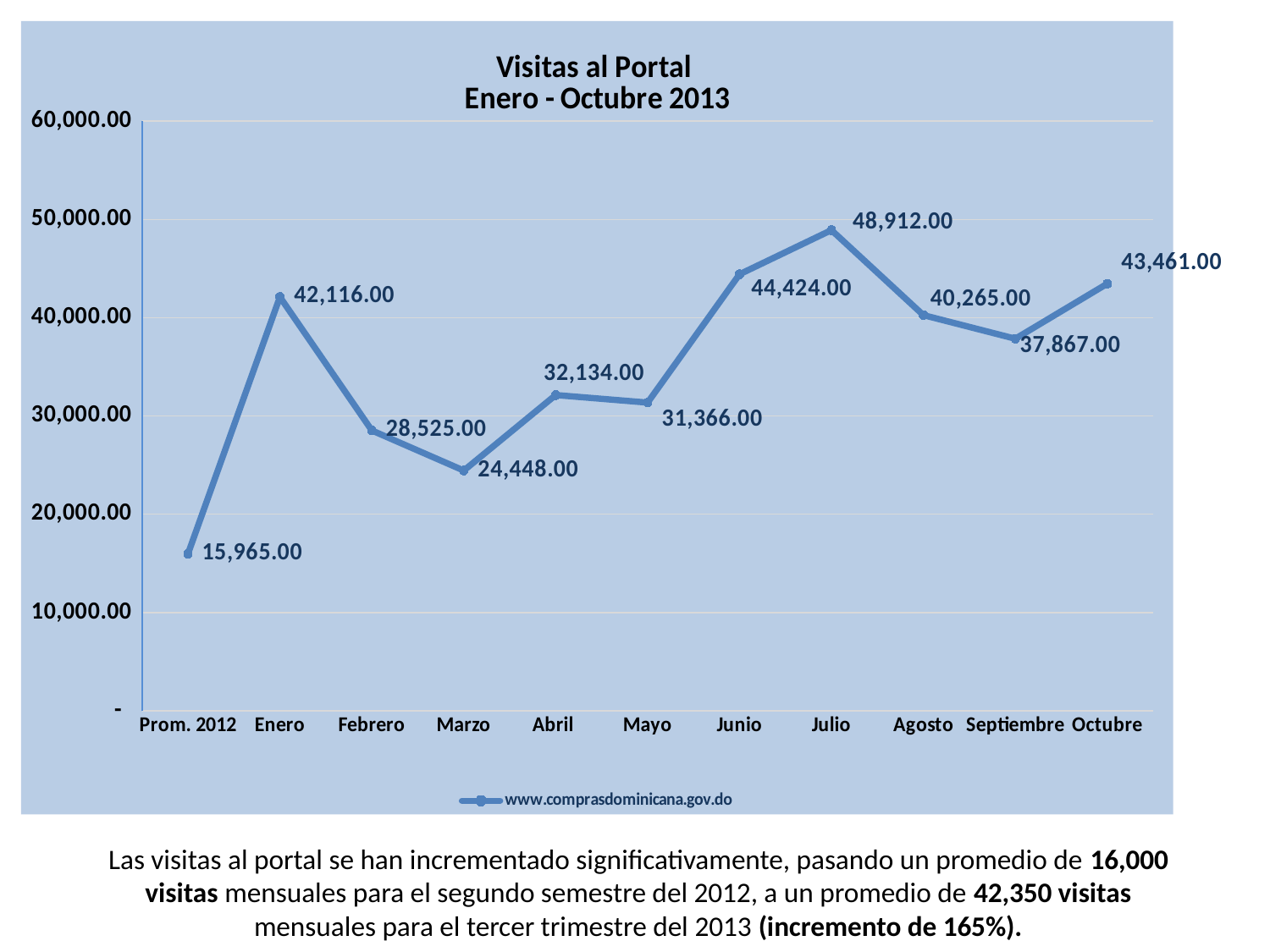
What is the difference between the values for Julio and Enero? 6,796.00 What is the value for Julio? 48,912.00 What is the value for Prom. 2012? 15,965.00 Is the value for Febrero greater or less than 30,000.00? less What is the legend entry for the plotted series? www.comprasdominicana.gov.do Which category has the highest value? Julio What kind of chart is shown? line chart What is the difference between the values for Octubre and Septiembre? 5,594.00 Which category has the lowest value? Prom. 2012 Which is larger, the value for Junio or the value for Agosto? Junio How many categories are plotted on the x axis? 11 What is the value for Marzo? 24,448.00